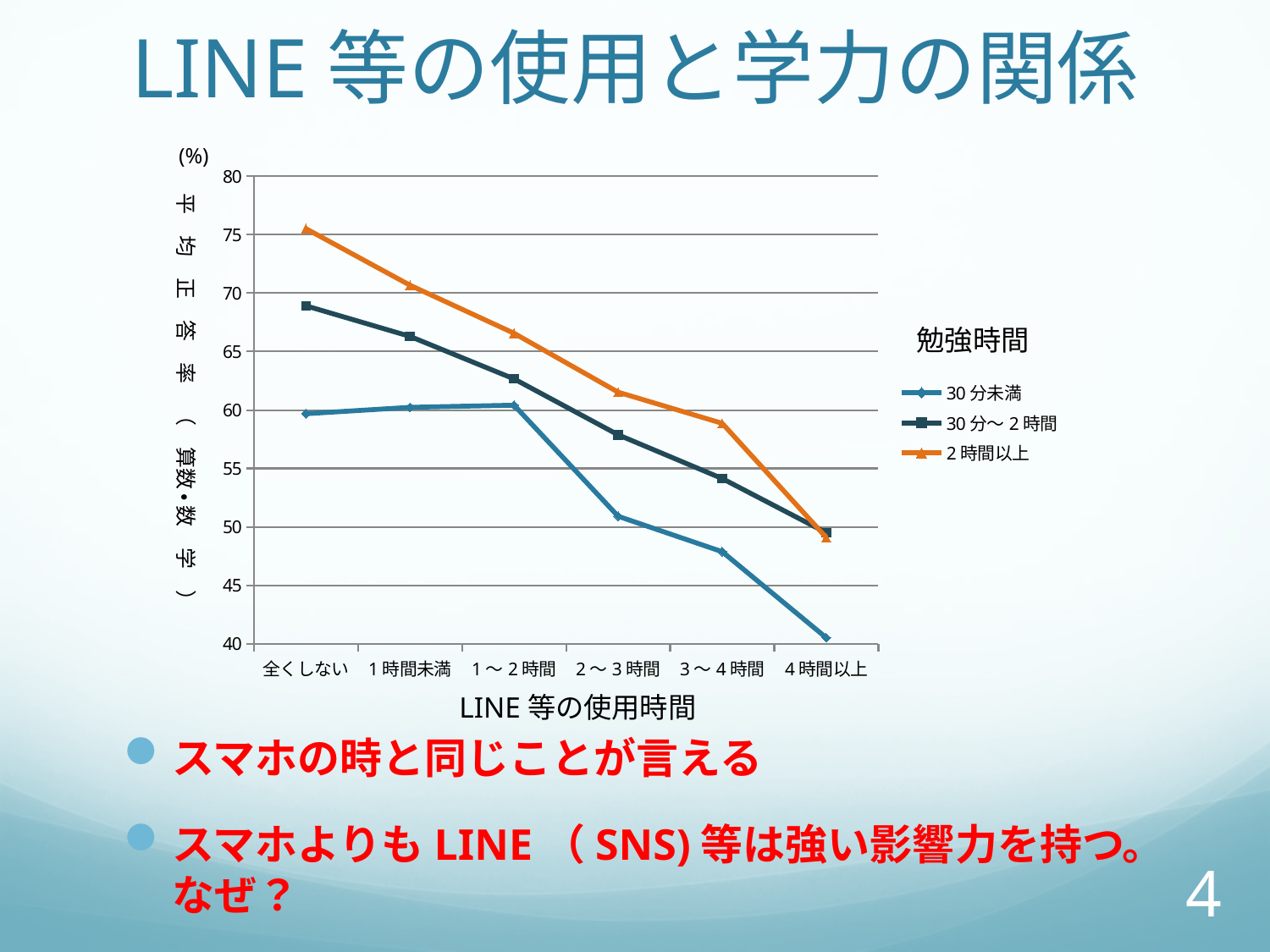
Is the value for 2時間以上 at 全くしない greater or less than 70? greater At 2～3時間, which is larger: the value for 30分～2時間 or for 30分未満? 30分～2時間 What is the title of the legend? 勉強時間 How many categories are on the x axis? 6 Is the value for 30分未満 at 2～3時間 greater or less than 55? less For the 30分未満 series, which category has the lowest value? 4時間以上 What kind of chart is shown on the slide? line chart Does the 30分～2時間 series rise or fall along the x axis? fall Is the value for 30分未満 at 4時間以上 greater or less than 45? less Which series has the highest value at 全くしない? 2時間以上 How many series does the legend list? 3 What is the x-axis title of the chart? LINE等の使用時間